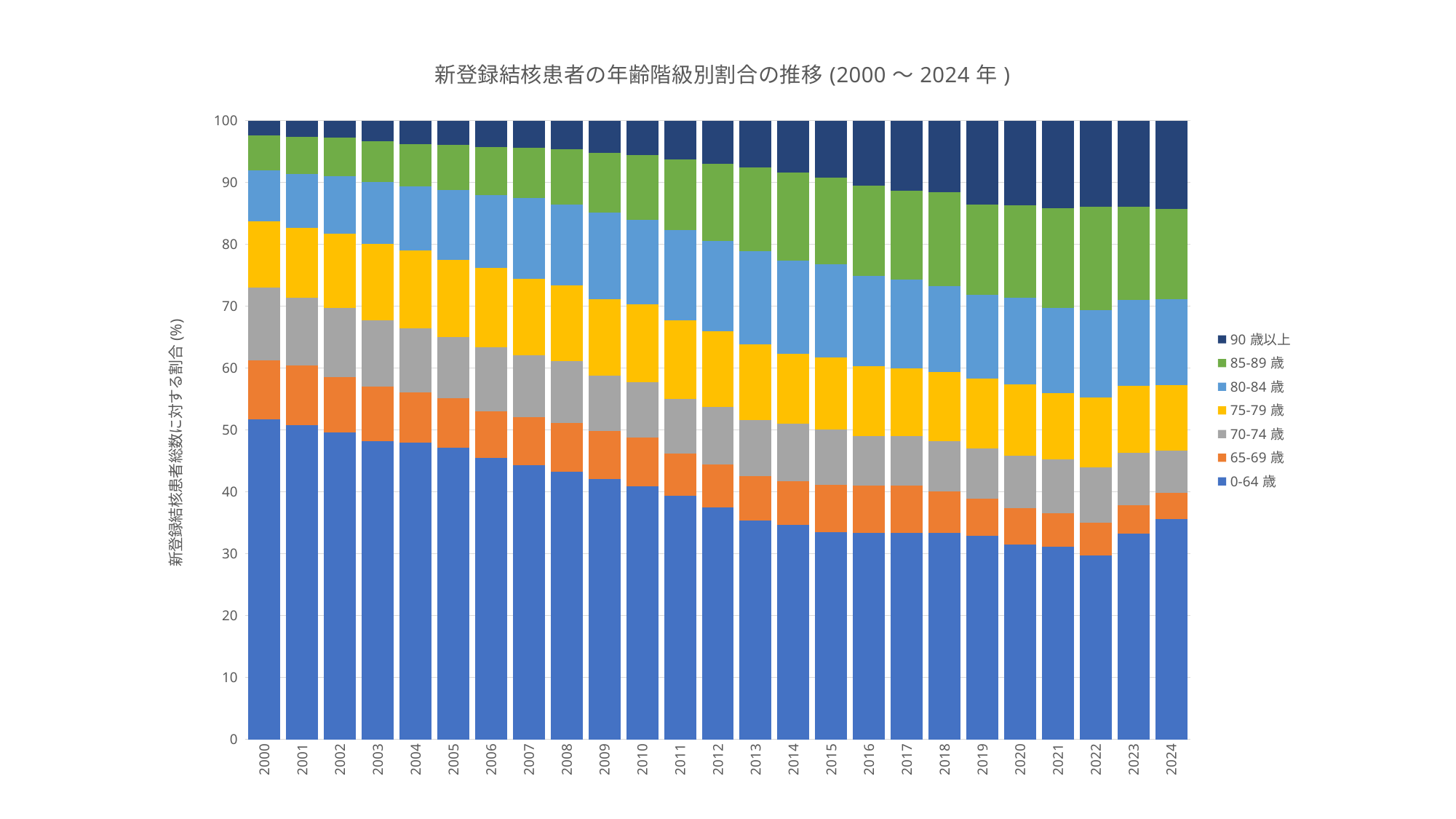
Does the share of the 0-64 歳 group rise or fall from 2000 to 2024 overall? Fall How many years (categories) are plotted along the x axis? 25 Which year has the largest share for the 0-64 歳 group? 2000 What kind of chart is shown on the slide? Stacked bar chart Is the share of the 0-64 歳 group in 2015 greater or less than 40? less How many series does the legend list? 7 Which legend entry is shown at the bottom of each stacked bar? 0-64 歳 Does the share of the 90 歳以上 group rise or fall from 2000 to 2024 overall? Rise Is the share of the 0-64 歳 group in 2000 larger or smaller than in 2024? Larger What is the title of the chart? 新登録結核患者の年齢階級別割合の推移 (2000 〜 2024 年 ) Is the share of the 0-64 歳 group in 2005 greater or less than 40? greater What is the total of the stacked bar for 2000? 100